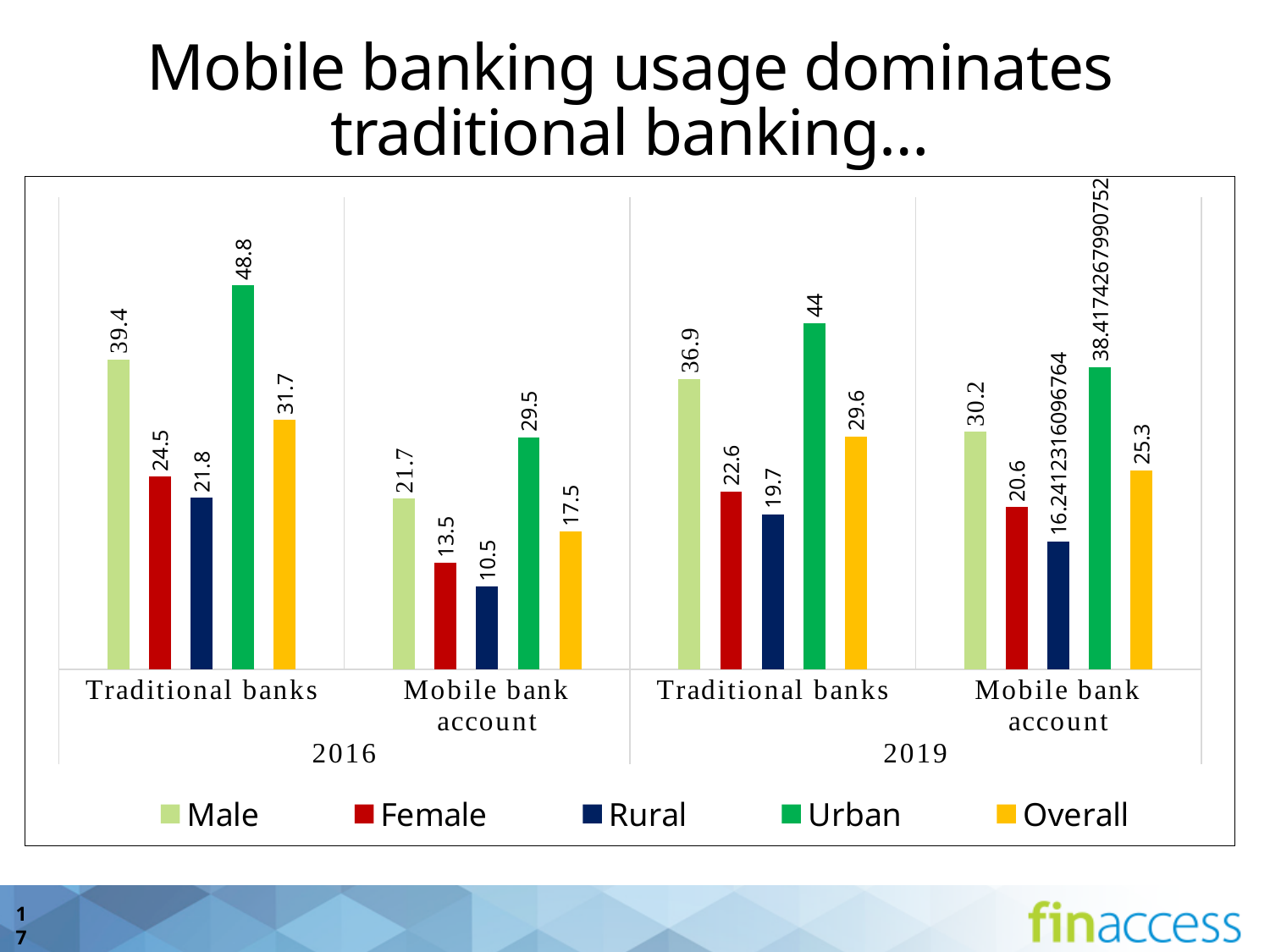
What is the Urban value for Traditional banks in 2016? 48.8 What is the difference between the Male and Female values for Traditional banks in 2016? 14.9 What kind of chart is shown on the slide? Bar chart Which series has the lowest value for Mobile bank account in 2016? Rural What is the Male value for Mobile bank account in 2019? 30.2 How many series does the legend list? 5 Which is larger: the Female value for Mobile bank account in 2016 or the Female value for Mobile bank account in 2019? 2019 What colour represents the Urban series in the chart? Green What is the difference between the Urban and Overall values for Traditional banks in 2019? 14.4 What is the Rural value for Mobile bank account in 2016? 10.5 Which series has the highest value for Traditional banks in 2016? Urban What is the Overall value for Traditional banks in 2019? 29.6